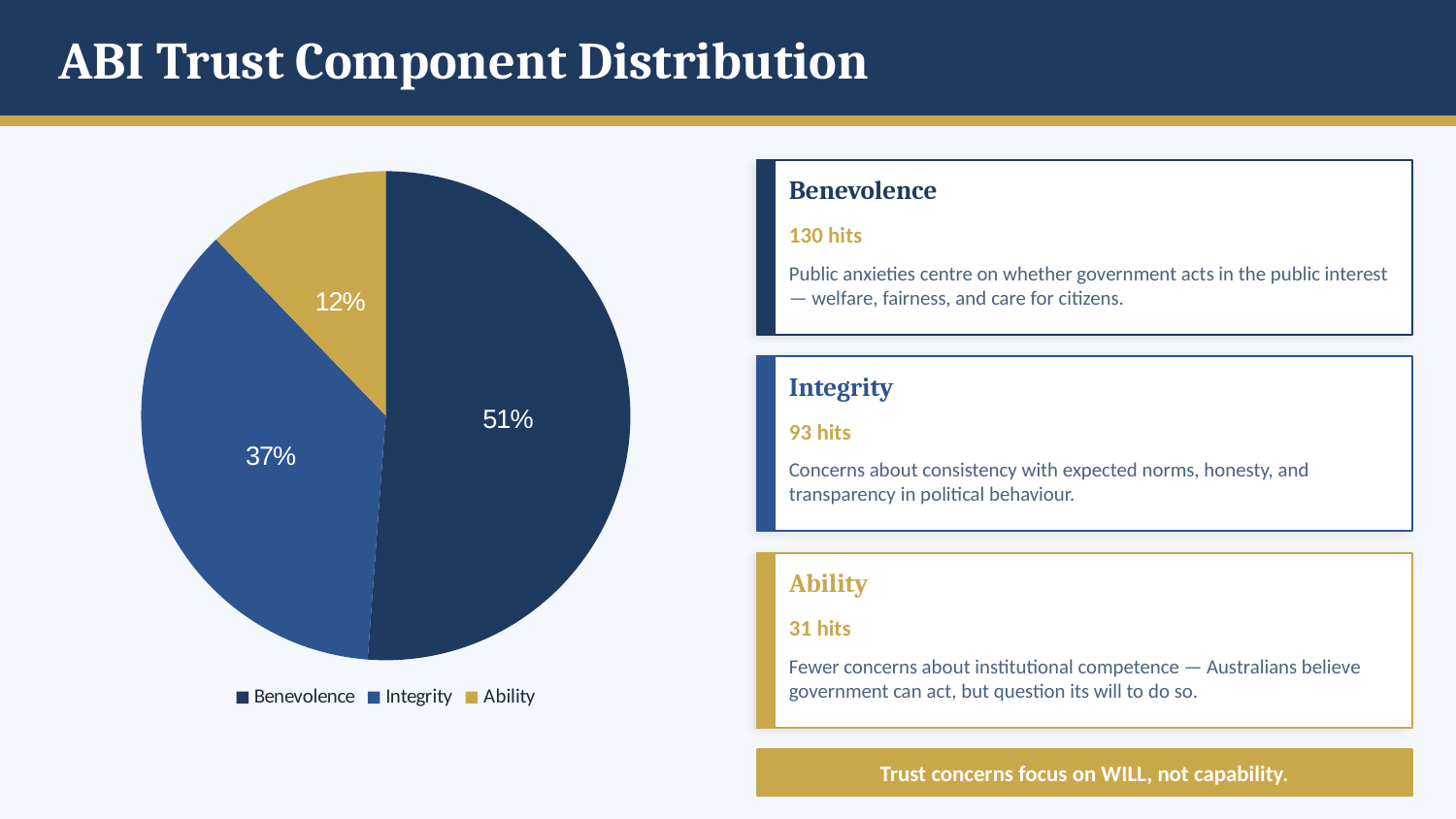
Which component has the largest share of the pie? Benevolence What is the difference in percentage points between the Integrity and Ability slices? 25 What type of chart is shown on the slide? Pie chart Which slice is larger, Integrity or Ability? Integrity How many slices does the pie chart have? 3 What is the title of the slide containing the pie chart? ABI Trust Component Distribution What is the difference in percentage points between the Benevolence and Integrity slices? 14 What percentage of the pie does Benevolence account for? 51% How many entries does the legend list? 3 What percentage of the pie does Integrity account for? 37% What percentage of the pie does Ability account for? 12% Which component has the smallest share of the pie? Ability